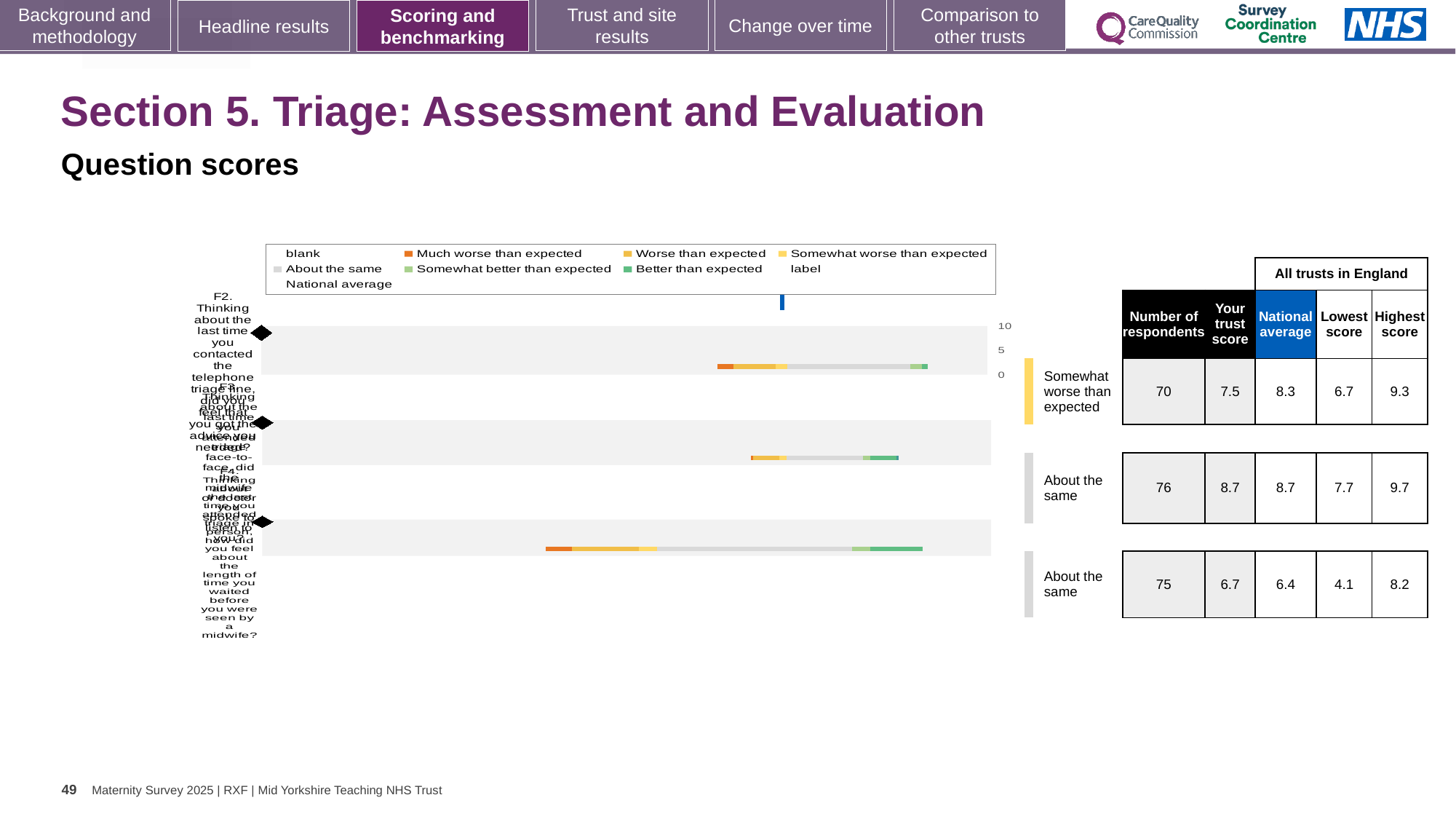
What is the number of respondents for the first question row (Somewhat worse than expected)? 70 What benchmark label is given to the second and third question rows? About the same What is the difference between the trust score and the national average for the third question row? 0.3 What is the national average for the first question row (Somewhat worse than expected)? 8.3 Is the trust score for the first question row larger or smaller than its national average? smaller Which question row has the lowest trust score? the third row (6.7) What is the highest score among all trusts in England for the second question row? 9.7 What is the trust score for the first question row (Somewhat worse than expected)? 7.5 How many question bars are plotted in the chart? 3 What kind of chart is shown on the slide? bar chart What is the lowest score among all trusts in England for the third question row? 4.1 Which question row has the highest trust score? the second row (8.7)